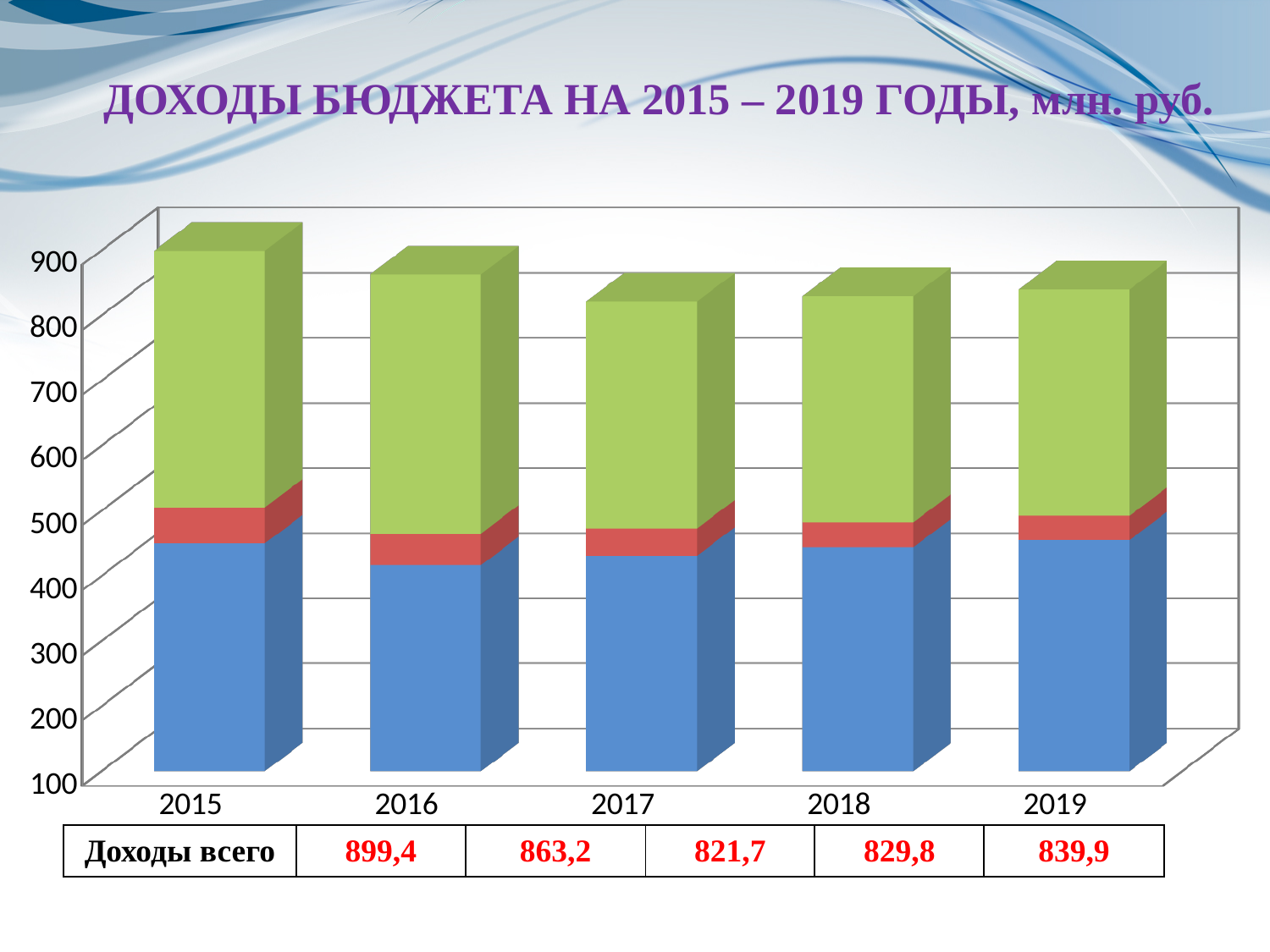
Which year has a larger total budget income, 2016 or 2018? 2016 What is the difference between the total budget income in 2019 and in 2018? 10,1 What is the total budget income (Доходы всего) for 2019? 839,9 How does the total budget income change from 2015 to 2017? It falls Which year has the highest total budget income? 2015 What is the total budget income (Доходы всего) for 2015? 899,4 Which year has the lowest total budget income? 2017 Is the value of the blue segment for 2015 greater or less than 400? greater What is the total budget income (Доходы всего) for 2017? 821,7 How many years are shown on the x axis of the chart? 5 What kind of chart is shown on the slide? Stacked bar chart What is the difference between the total budget income in 2015 and in 2016? 36,2